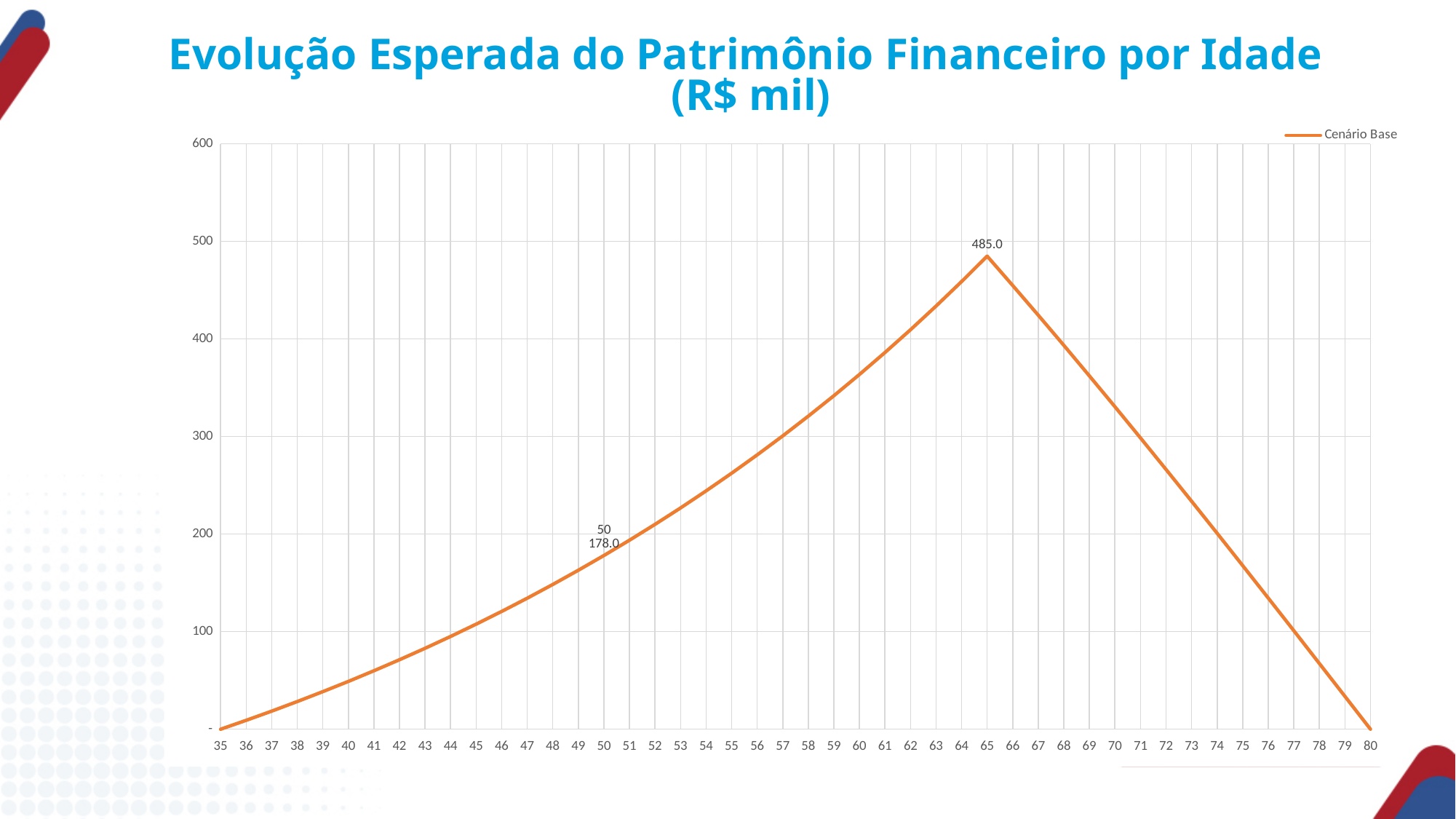
What is the name of the series shown in the legend? Cenário Base Is the value for age 75 greater or less than 200? less What type of chart is shown on the slide? line chart At which age does the Cenário Base line reach its highest value? 65 How many series does the legend list? 1 Which is larger, the value at age 50 or the value at age 65? age 65 Does the line rise or fall between age 65 and age 80? fall Is the value for age 40 greater or less than 100? less Is the value for age 60 greater or less than 300? greater What is the difference between the values at age 65 and age 50? 307.0 What is the value of Cenário Base at age 50? 178.0 What is the value of Cenário Base at age 65? 485.0